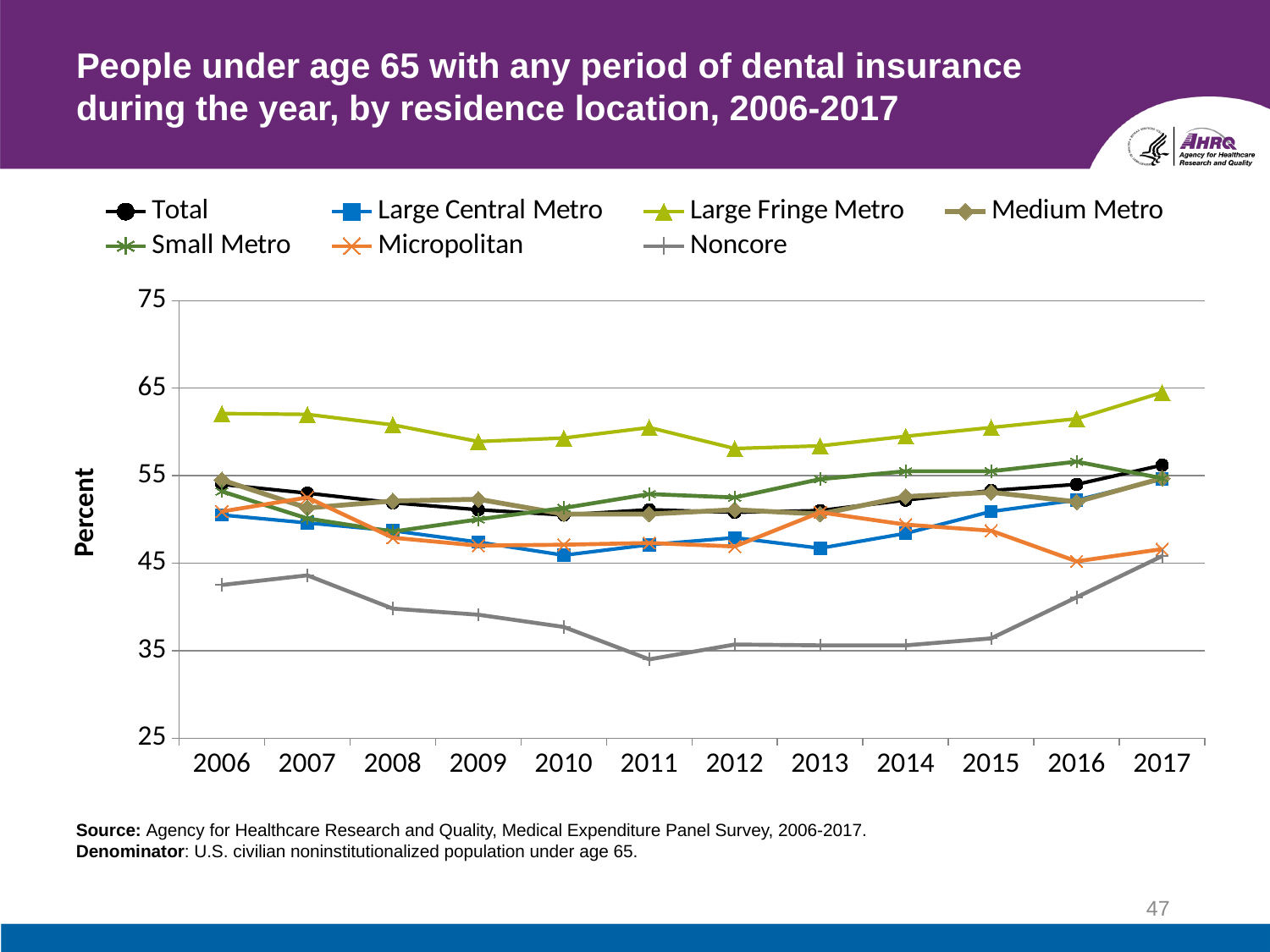
Does the Large Fringe Metro line rise or fall from 2013 to 2017? rise What is the label on the y axis? Percent Is the value for Large Fringe Metro in 2006 greater or less than 55? greater Does the Noncore line rise or fall from 2006 to 2011? fall Is the value for Noncore in 2011 greater or less than 35? less Is the value for Noncore in 2006 greater or less than 45? less How many years are plotted along the x axis? 12 Which is larger in 2013, the value for Large Fringe Metro or the value for Micropolitan? Large Fringe Metro What kind of chart is shown on the slide? line chart Which residence location has the lowest percentage in 2011? Noncore Which residence location has the highest percentage in 2017? Large Fringe Metro How many series does the legend list? 7